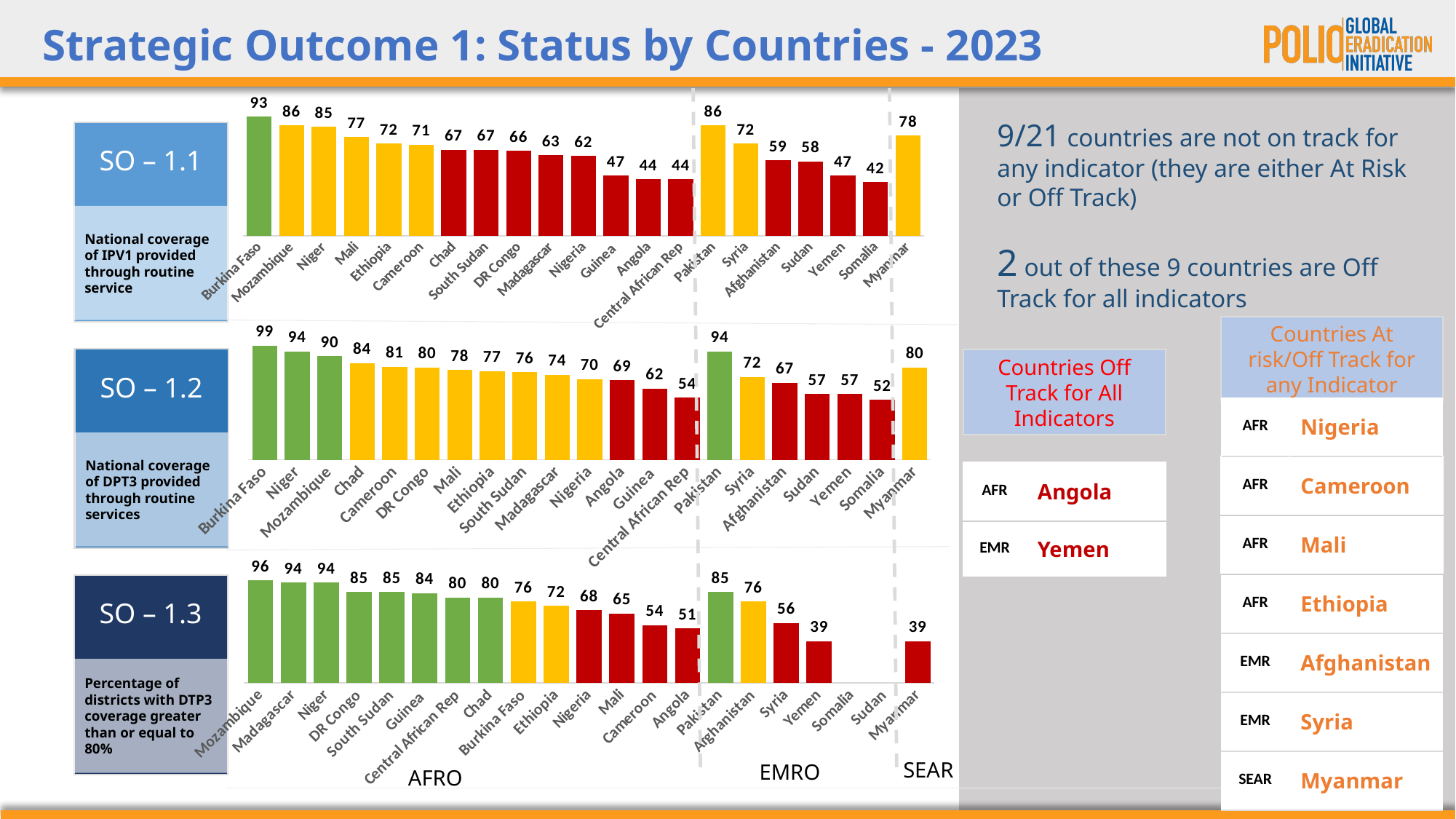
In the SO – 1.3 chart (percentage of districts with DTP3 coverage ≥ 80%), what is the value for Yemen? 39 What type of chart is used for SO – 1.1? Bar chart In the SO – 1.1 chart (national coverage of IPV1), what is the difference between Pakistan and Afghanistan? 27 In the SO – 1.2 chart (national coverage of DPT3), which is larger, the value for Nigeria or the value for Central African Rep? Nigeria In the SO – 1.1 chart (national coverage of IPV1), which country has the lowest value? Somalia Which three regions are labelled along the bottom of the charts? AFRO, EMRO, SEAR In the SO – 1.3 chart (percentage of districts with DTP3 coverage ≥ 80%), what is the value for Mozambique? 96 In the SO – 1.1 chart (national coverage of IPV1), what is the value for Burkina Faso? 93 In the SO – 1.3 chart (percentage of districts with DTP3 coverage ≥ 80%), what is the difference between Pakistan and Syria? 29 How many countries are shown on the x axis of the SO – 1.2 chart? 21 In the SO – 1.2 chart (national coverage of DPT3), what is the value for Myanmar? 80 In the SO – 1.2 chart (national coverage of DPT3), which country has the highest value? Burkina Faso